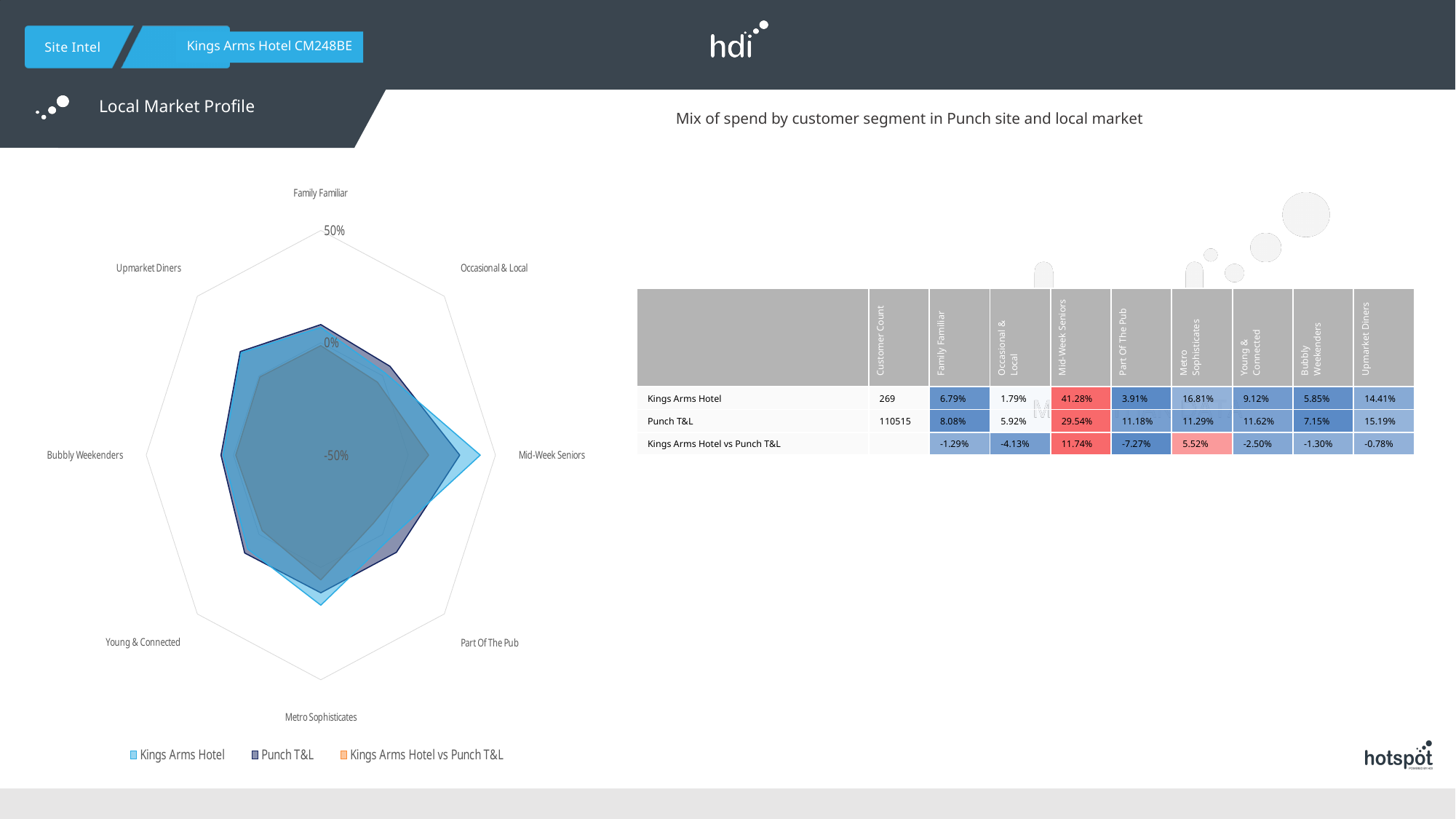
Which customer segment has the highest value for Punch T&L? Mid-Week Seniors For Part Of The Pub, which is larger: Kings Arms Hotel or Punch T&L? Punch T&L Which customer segment has the lowest value for Kings Arms Hotel? Occasional & Local According to the table, what is the Customer Count for Punch T&L? 110515 According to the table, what is the Part Of The Pub value for Punch T&L? 11.18% What is the difference between Kings Arms Hotel and Punch T&L for Mid-Week Seniors, as shown in the table? 11.74% How many series does the radar chart's legend list? 3 What kind of chart is shown on the left of the slide? Radar chart Which customer segment has the highest value for Kings Arms Hotel? Mid-Week Seniors What is the highest percentage tick shown on the radar chart's axis? 50% How many customer segment categories does the radar chart have? 8 According to the table, what is the Mid-Week Seniors value for Kings Arms Hotel? 41.28%